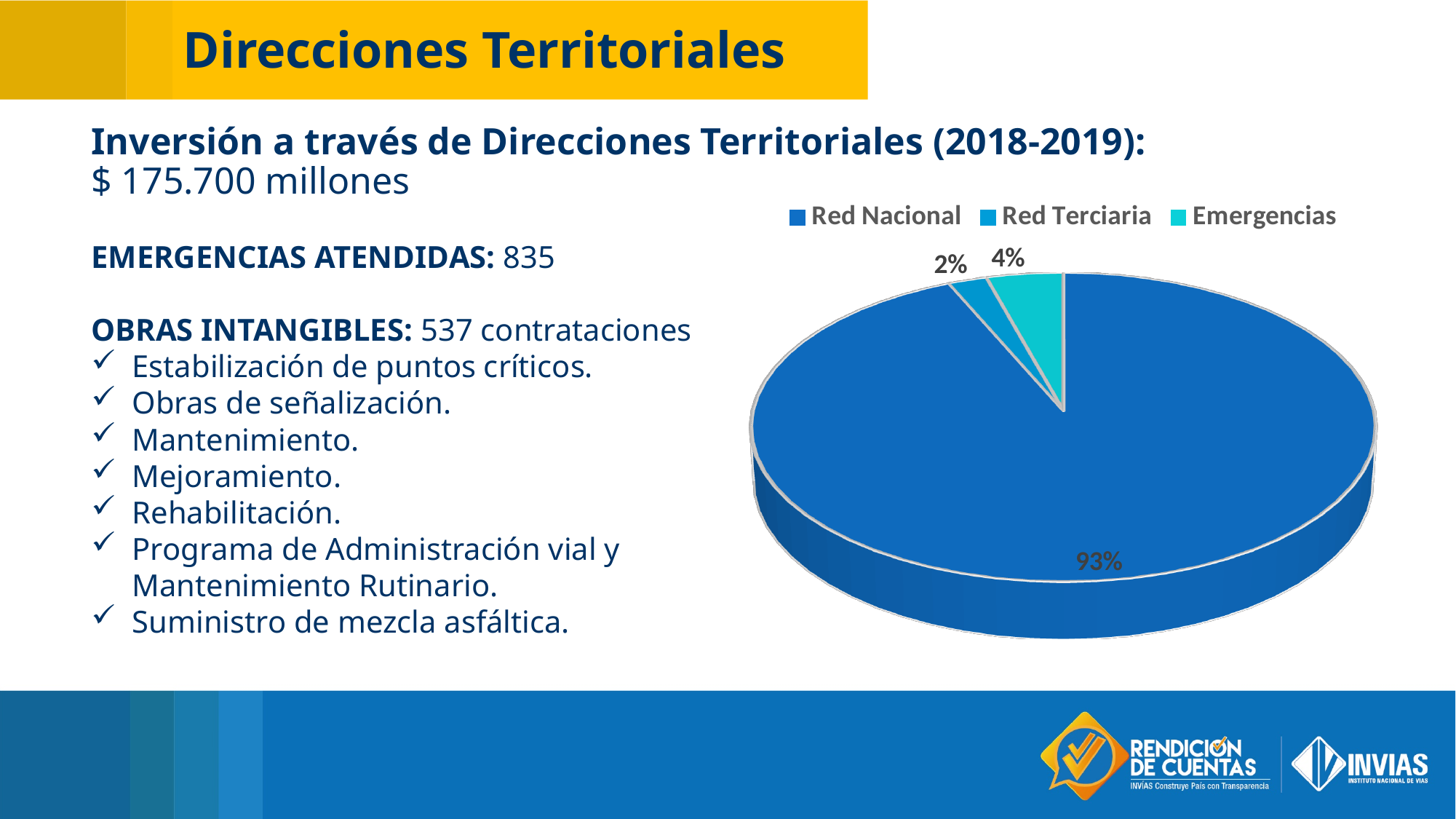
Which category has the largest slice of the pie? Red Nacional How many entries does the legend list? 3 What is the difference in percentage points between the Emergencias slice and the Red Terciaria slice? 2 What share of the pie does Emergencias represent? 4% Which legend entry is shown in the lightest (cyan) colour? Emergencias What is the difference in percentage points between the Red Nacional slice and the Emergencias slice? 89 What kind of chart is shown on the slide? Pie chart How many slices does the pie chart have? 3 Which category has the smallest slice of the pie? Red Terciaria What share of the pie does Red Nacional represent? 93% What share of the pie does Red Terciaria represent? 2% Which is larger, the slice for Emergencias or the slice for Red Terciaria? Emergencias